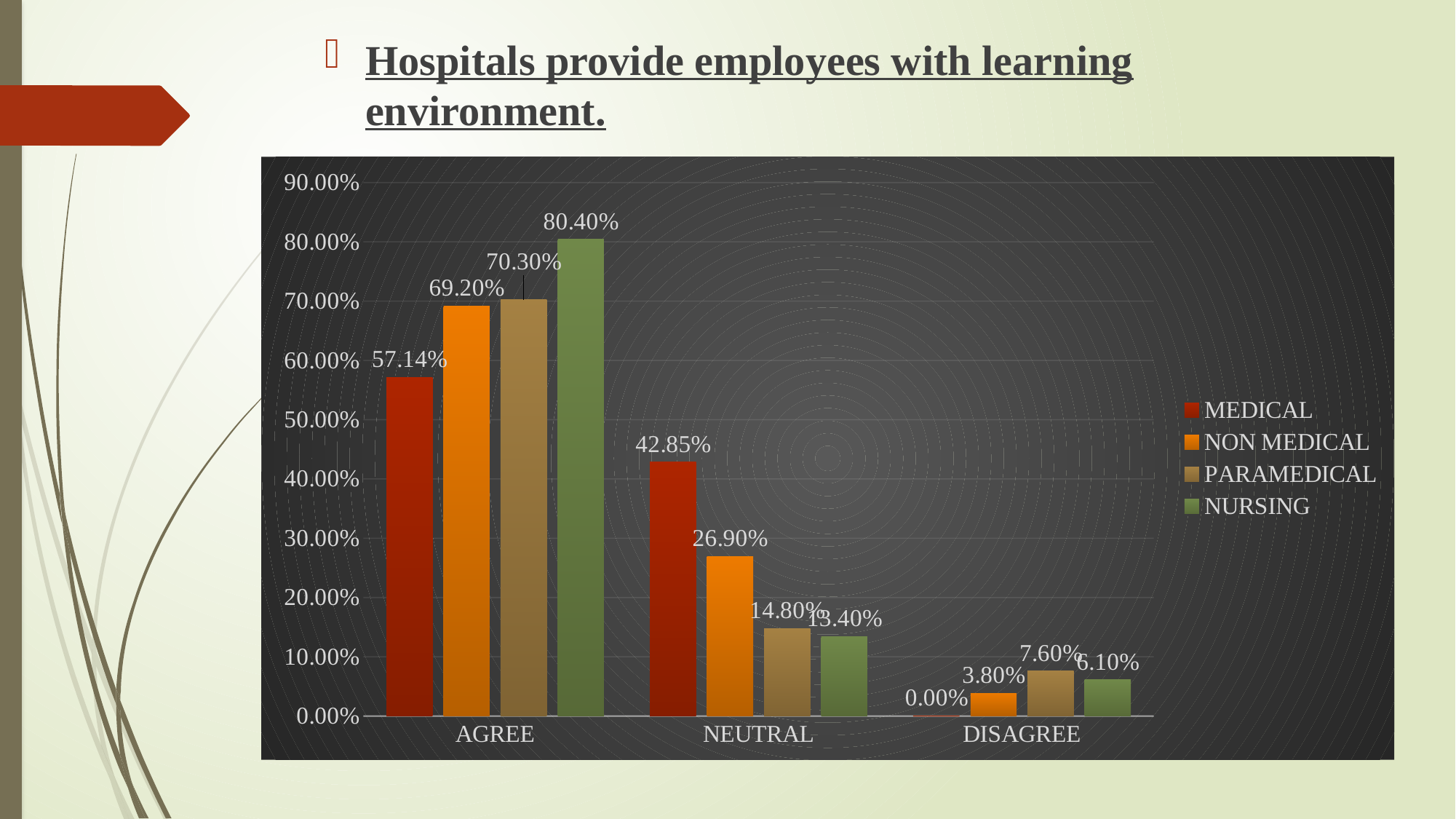
Which is larger in the DISAGREE category: PARAMEDICAL or NURSING? PARAMEDICAL What is the difference between the NURSING and MEDICAL values in the AGREE category? 23.26% What kind of chart is shown on the slide? bar chart How many series does the legend list? 4 What is the value for NURSING in the AGREE category? 80.40% Which series has the lowest value in the NEUTRAL category? NURSING What is the value for PARAMEDICAL in the DISAGREE category? 7.60% Which series has the highest value in the AGREE category? NURSING Is the value for NON MEDICAL in the NEUTRAL category greater or less than 30.00%? less What is the value for MEDICAL in the DISAGREE category? 0.00% How many categories are shown on the x axis? 3 What is the value for MEDICAL in the NEUTRAL category? 42.85%